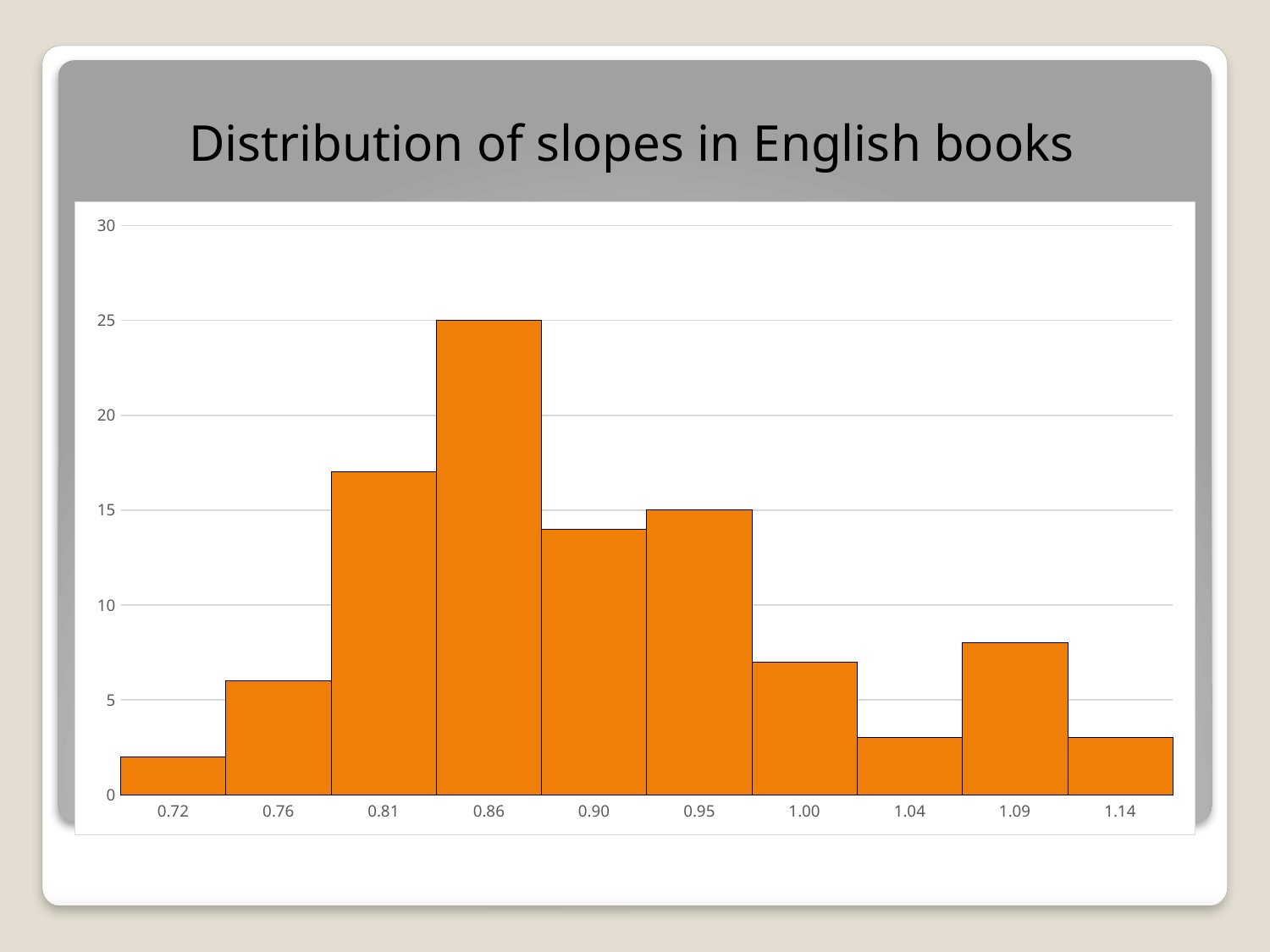
What is the value for the 0.86 bin? 25 What is the title of the chart? Distribution of slopes in English books Is the value for the 0.81 bin greater or less than 15? greater Is the value for the 1.09 bin greater or less than 5? greater How many bars are plotted in the chart? 10 Which slope bin has the lowest bar? 0.72 What is the value for the 0.95 bin? 15 Which bin has a larger value, 0.81 or 0.90? 0.81 What type of chart is shown on the slide? bar chart Which slope bin has the highest bar? 0.86 Is the value for the 1.04 bin greater or less than 5? less What is the difference between the values for the 0.86 bin and the 0.95 bin? 10